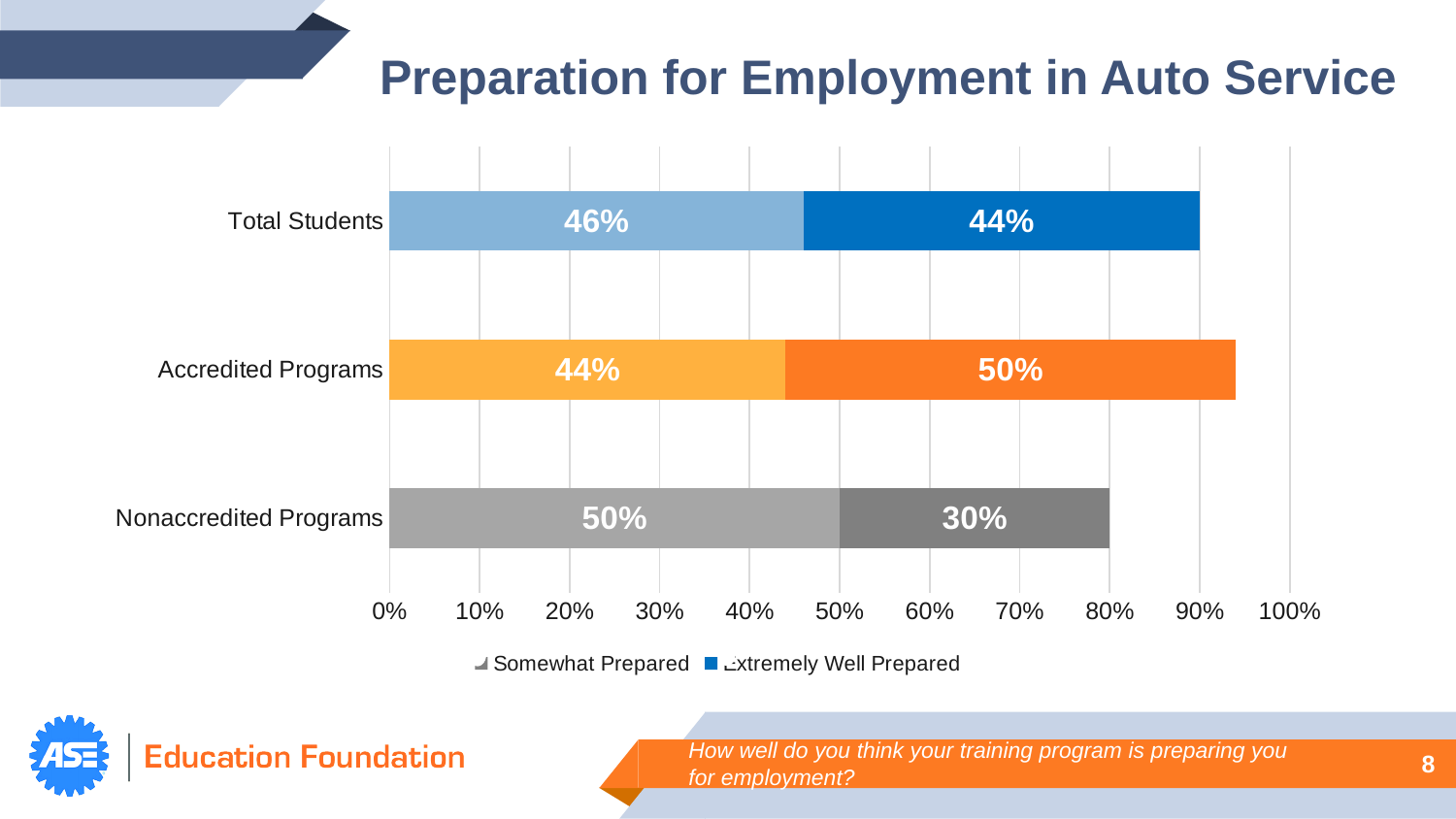
What type of chart is shown on the slide? Stacked bar chart Which is larger: the Somewhat Prepared share for Nonaccredited Programs or for Total Students? Nonaccredited Programs What percentage of students in Nonaccredited Programs said they were Extremely Well Prepared? 30% Which group has the highest Extremely Well Prepared percentage? Accredited Programs Which group has the lowest Extremely Well Prepared percentage? Nonaccredited Programs How many series does the legend list? 2 What percentage of students in Accredited Programs said they were Extremely Well Prepared? 50% What is the combined total of Somewhat Prepared and Extremely Well Prepared for Accredited Programs? 94% What is the difference between the Extremely Well Prepared percentages for Accredited Programs and Nonaccredited Programs? 20% What percentage of Total Students said they were Somewhat Prepared? 46% What is the combined total of Somewhat Prepared and Extremely Well Prepared for Nonaccredited Programs? 80% How many groups (categories) are shown in the chart? 3